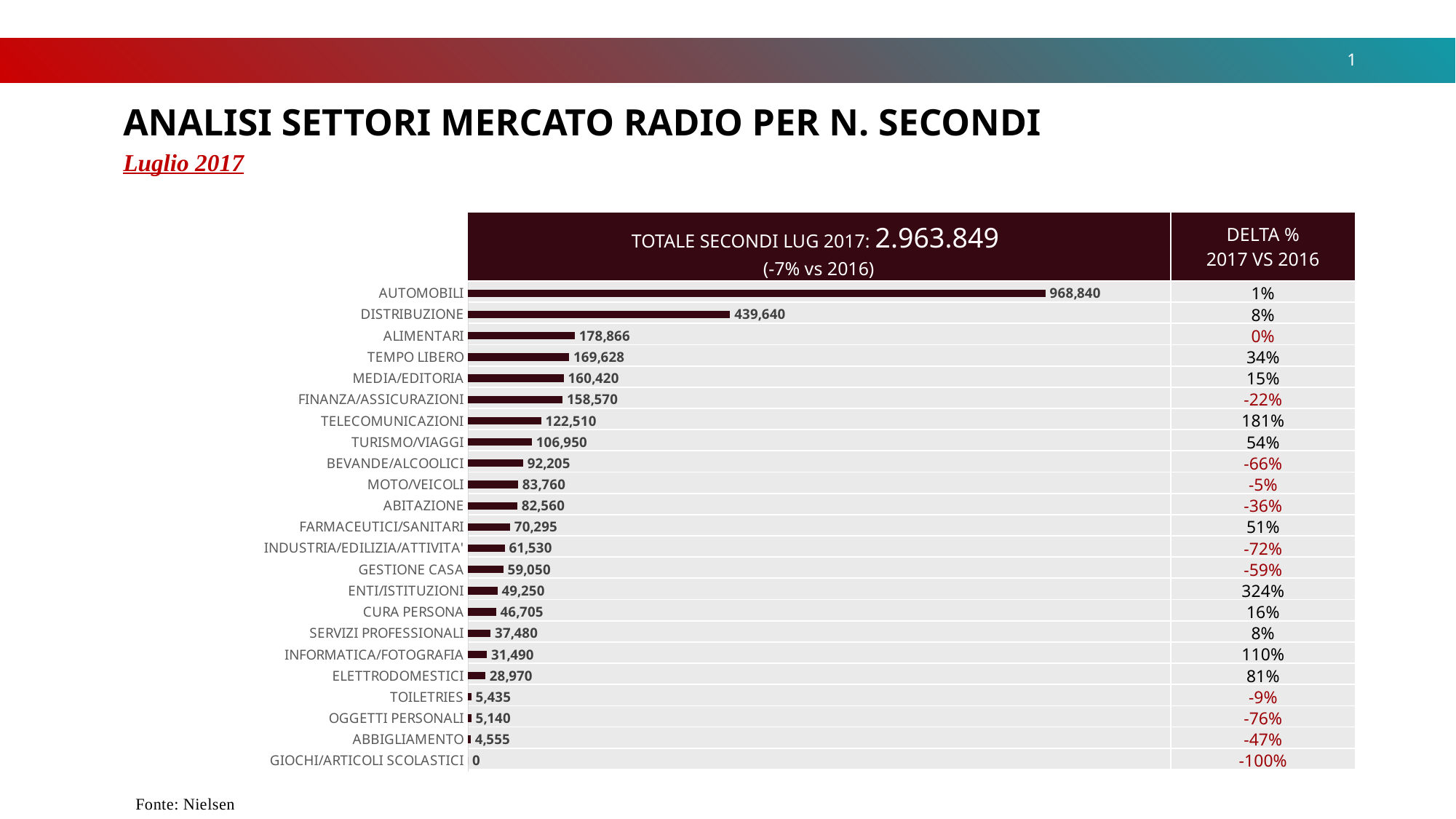
What is the difference between the values for AUTOMOBILI and DISTRIBUZIONE? 529,200 What is the value for TELECOMUNICAZIONI? 122,510 What is the difference between the values for ALIMENTARI and TEMPO LIBERO? 9,238 Which category has the lowest value? GIOCHI/ARTICOLI SCOLASTICI What is the value for GESTIONE CASA? 59,050 How many categories are shown in the chart? 23 Which is larger, the value for TURISMO/VIAGGI or the value for BEVANDE/ALCOOLICI? TURISMO/VIAGGI Which category has the highest value? AUTOMOBILI What kind of chart is shown on the slide? bar chart What is the DELTA % 2017 VS 2016 shown for ENTI/ISTITUZIONI? 324% What total number of seconds for July 2017 is shown in the chart header? 2.963.849 What is the value for AUTOMOBILI? 968,840